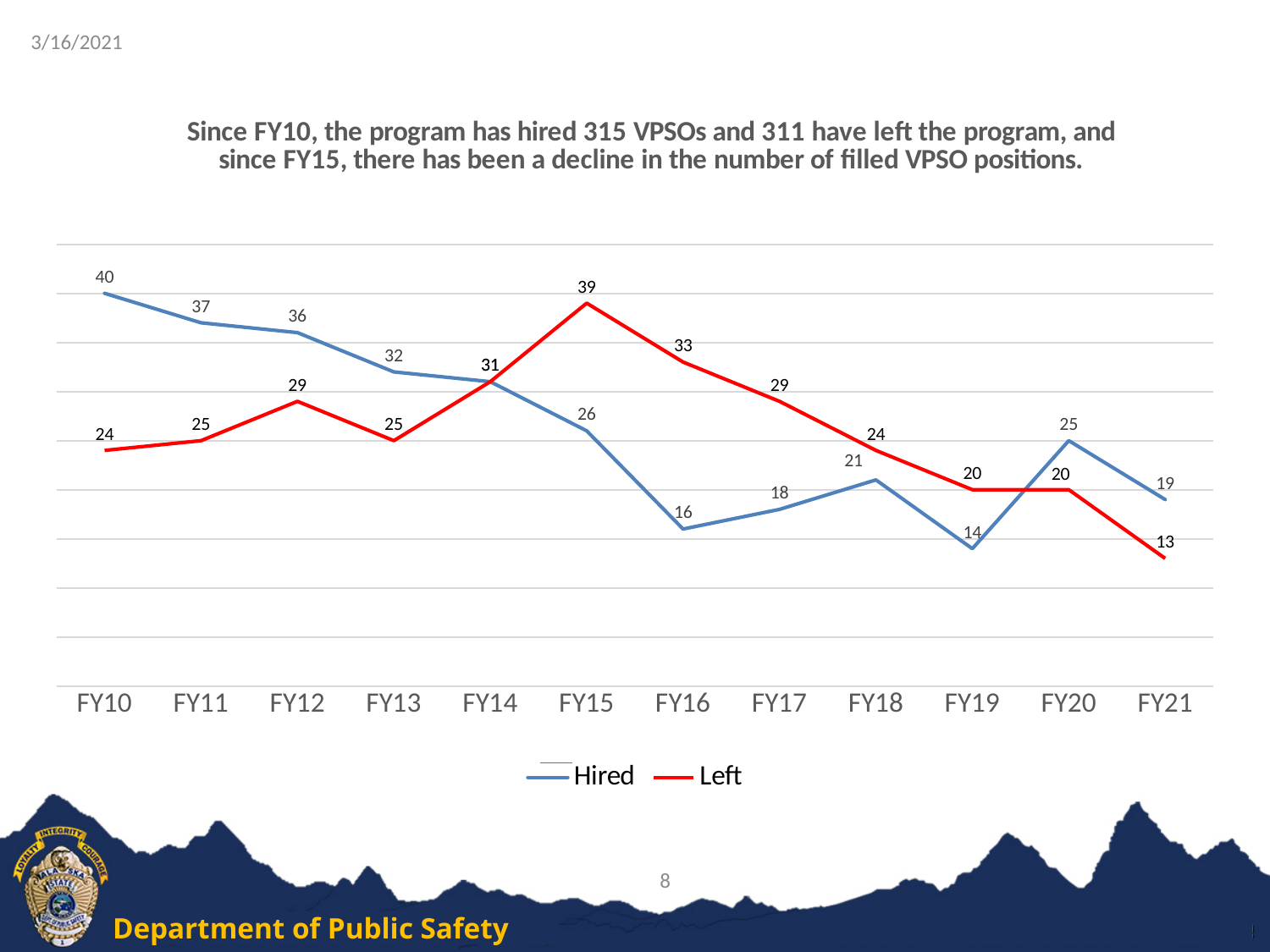
What is the Hired value for FY10? 40 In which fiscal year is the Left series lowest? FY21 In which fiscal year is the Hired series highest? FY10 In FY16, which is larger, Hired or Left? Left Which colour is used for the Left series? red How many fiscal years are plotted on the x axis? 12 How many series does the legend list? 2 What is the difference between the Left and Hired values in FY15? 13 What is the Left value for FY15? 39 What is the Left value for FY21? 13 What type of chart is shown on the slide? line chart What is the Hired value for FY19? 14